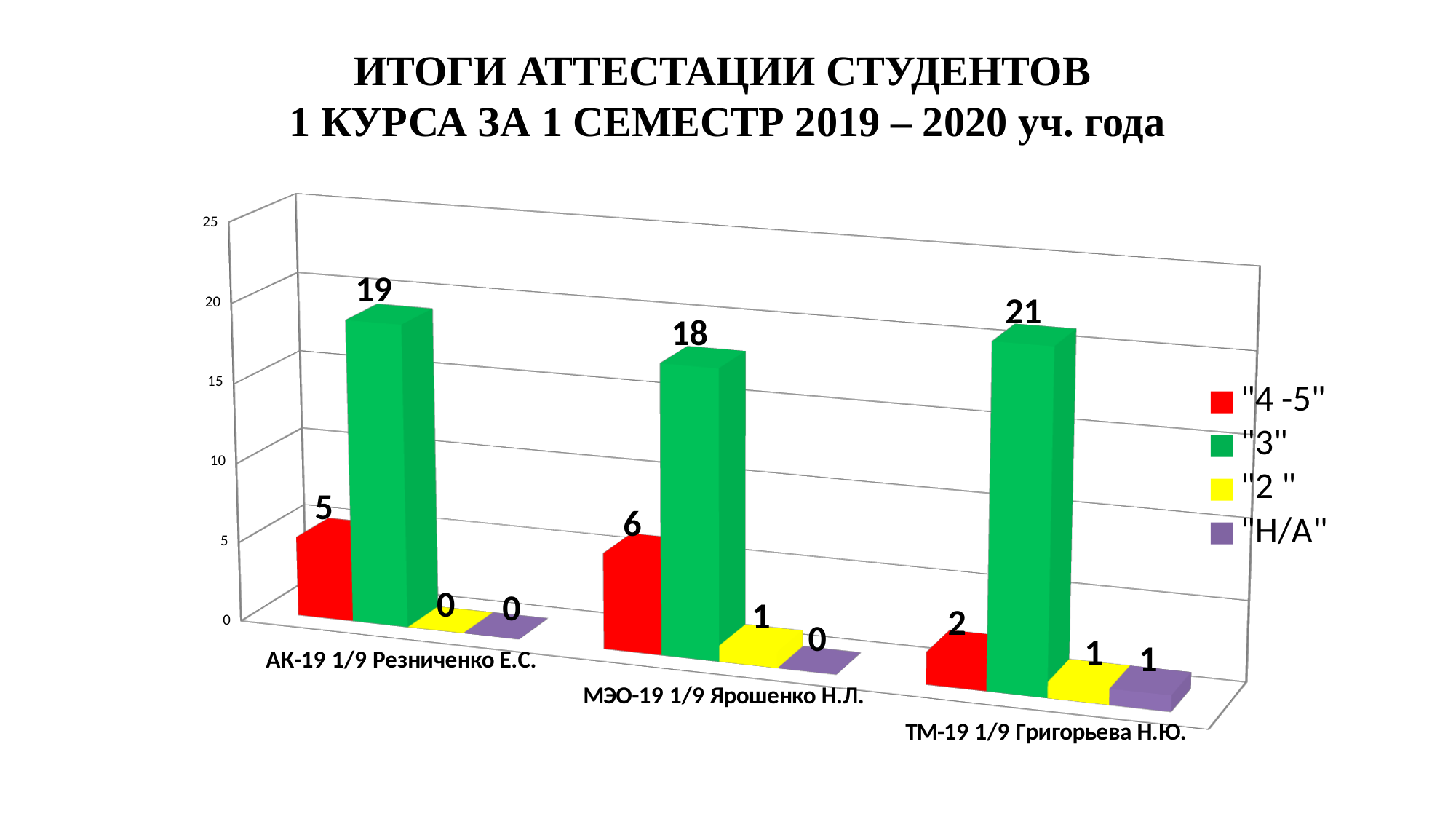
What kind of chart is shown on the slide? bar chart How many series does the legend list? 4 What is the difference between the "3" values for ТМ-19 1/9 Григорьева Н.Ю. and МЭО-19 1/9 Ярошенко Н.Л.? 3 What is the value of the "Н/А" series for АК-19 1/9 Резниченко Е.С.? 0 What is the total of the "2 " series across all three groups? 2 What is the value of the "3" series for ТМ-19 1/9 Григорьева Н.Ю.? 21 Which group has the highest value in the "3" series? ТМ-19 1/9 Григорьева Н.Ю. Which is larger: the "4 -5" value for АК-19 1/9 Резниченко Е.С. or for МЭО-19 1/9 Ярошенко Н.Л.? МЭО-19 1/9 Ярошенко Н.Л. How many groups (categories) are shown on the x axis? 3 What is the value of the "4 -5" series for МЭО-19 1/9 Ярошенко Н.Л.? 6 What colour represents the "3" series in the legend? green Which group has the lowest value in the "4 -5" series? ТМ-19 1/9 Григорьева Н.Ю.